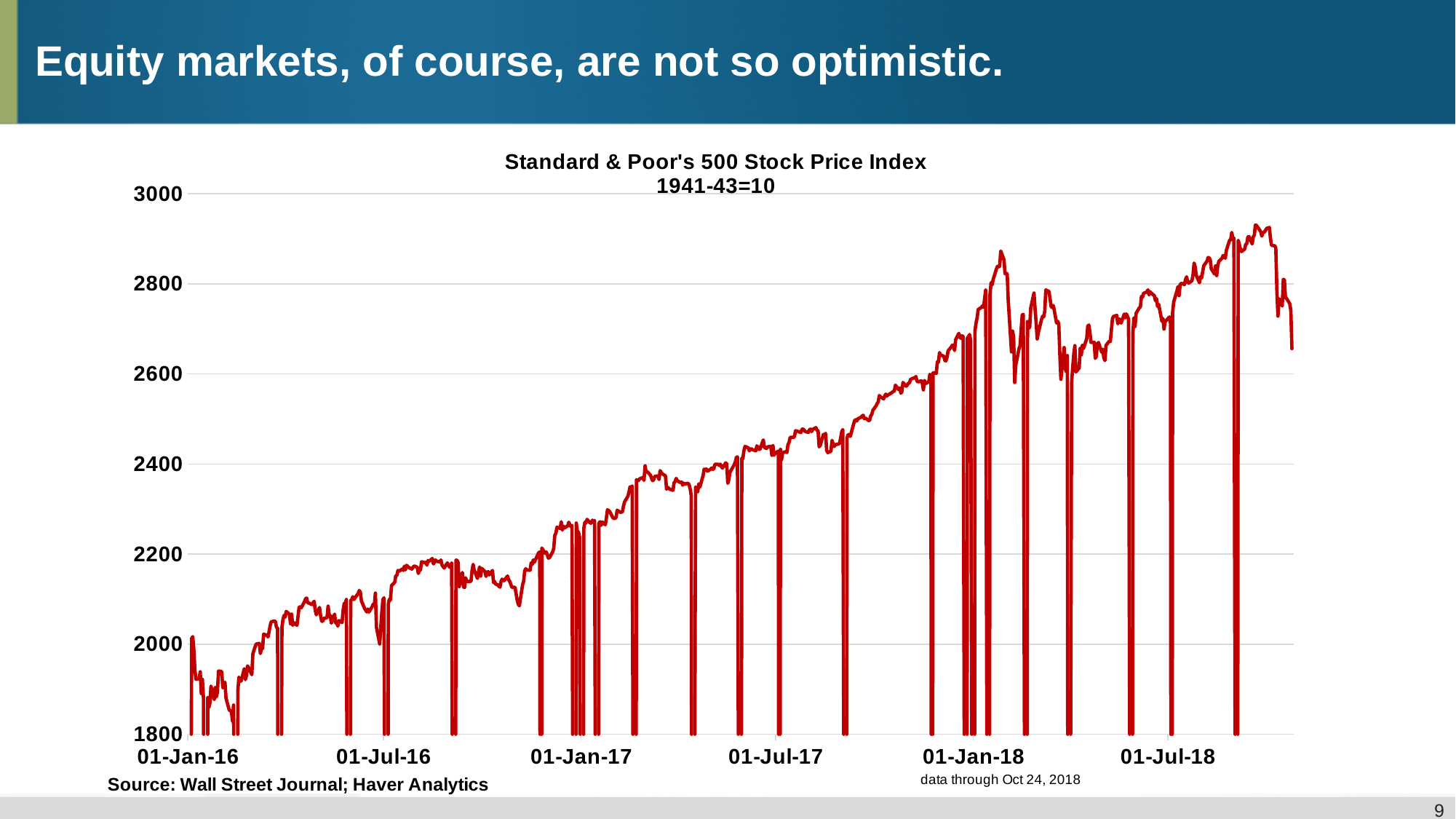
What is the highest value shown on the y axis? 3000 Overall, does the S&P 500 index rise or fall from 01-Jan-16 to the end of the series? rise Is the index higher at 01-Jul-18 or at 01-Jan-16? 01-Jul-18 Is the value of the index at 01-Jul-17 greater or less than 2200? greater What kind of chart is shown on the slide? line chart Is the value of the index at 01-Jan-18 greater or less than 2600? greater How many date labels are shown on the x axis? 6 Is the value of the index at 01-Jan-16 greater or less than 2200? less What is the title of the chart? Standard & Poor's 500 Stock Price Index 1941-43=10